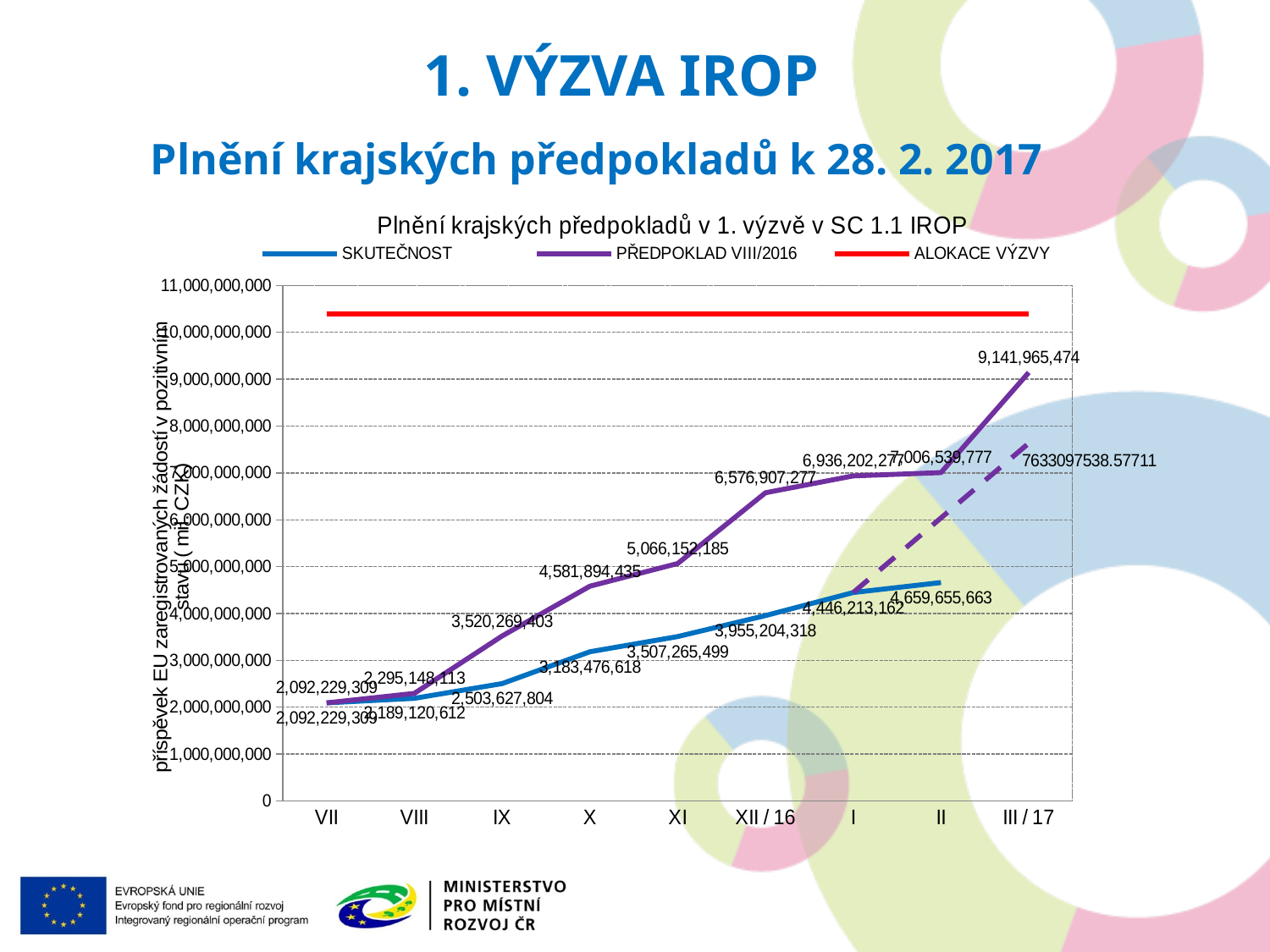
What is the difference between PŘEDPOKLAD VIII/2016 and SKUTEČNOST at XI? 1,558,886,686 What is the value of PŘEDPOKLAD VIII/2016 at III / 17? 9,141,965,474 What kind of chart is shown on the slide? line chart Does the SKUTEČNOST series rise or fall from VII to II? rise What is the value of SKUTEČNOST at X? 3,183,476,618 Is the value of ALOKACE VÝZVY greater or less than 10,000,000,000? greater At I, which series has the higher value, PŘEDPOKLAD VIII/2016 or SKUTEČNOST? PŘEDPOKLAD VIII/2016 What is the value of PŘEDPOKLAD VIII/2016 at XII / 16? 6,576,907,277 How many categories are shown on the x axis of the chart? 9 What is the value of SKUTEČNOST at XII / 16? 3,955,204,318 How many series does the chart legend list? 3 What is the value of SKUTEČNOST at II? 4,659,655,663